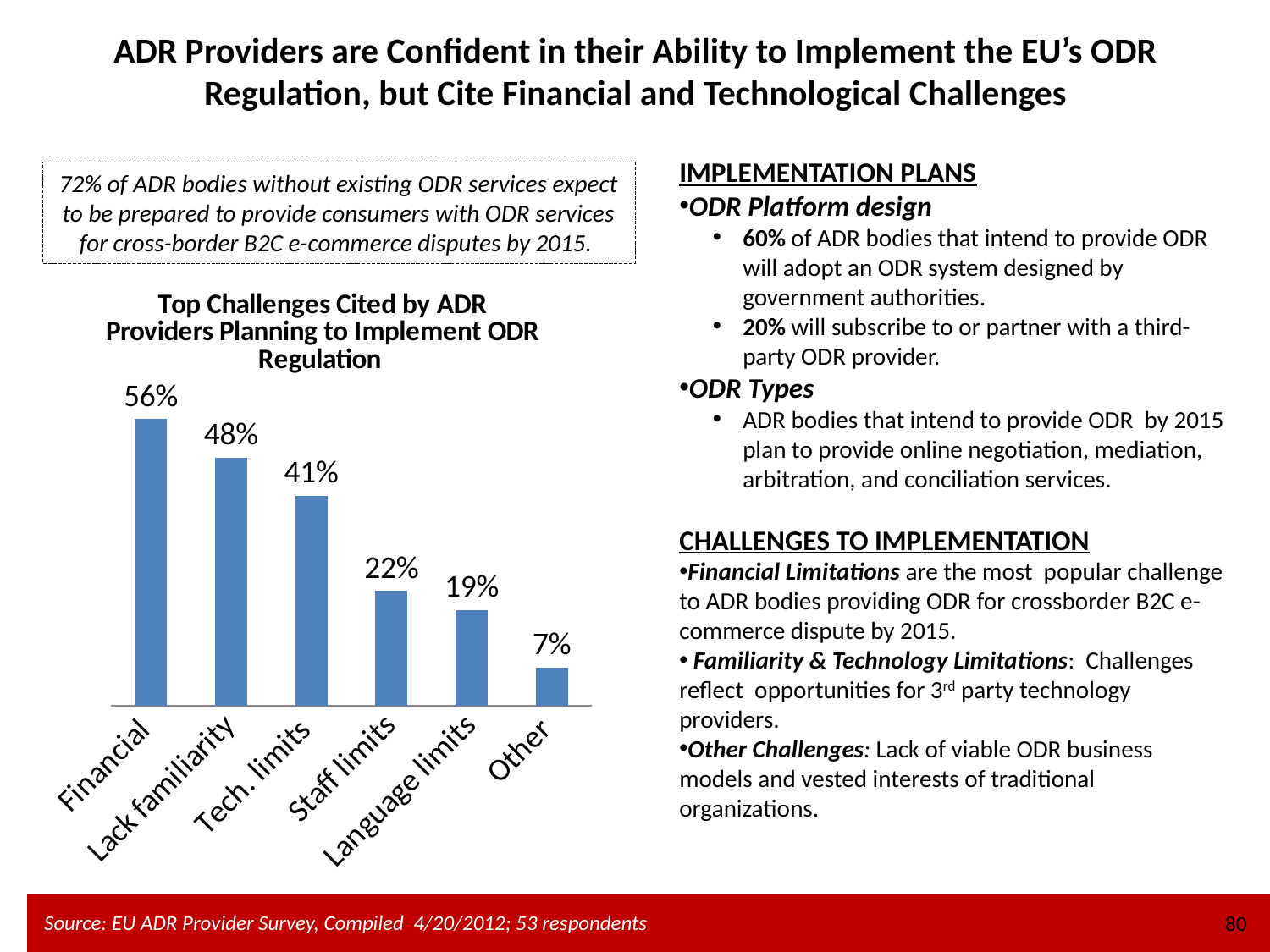
How many categories are shown in the chart? 6 Do the values rise or fall from left to right along the x axis? Fall What is the difference between the values for Financial and Lack familiarity? 8% What is the difference between the values for Staff limits and Other? 15% Which is larger, the value for Lack familiarity or the value for Tech. limits? Lack familiarity What is the value for Language limits in the chart? 19% What is the value for Tech. limits in the chart? 41% Which category has the lowest value in the chart? Other What is the value for Financial in the chart? 56% What kind of chart is shown on the slide? Bar chart What is the title of the chart? Top Challenges Cited by ADR Providers Planning to Implement ODR Regulation Which category has the highest value in the chart? Financial